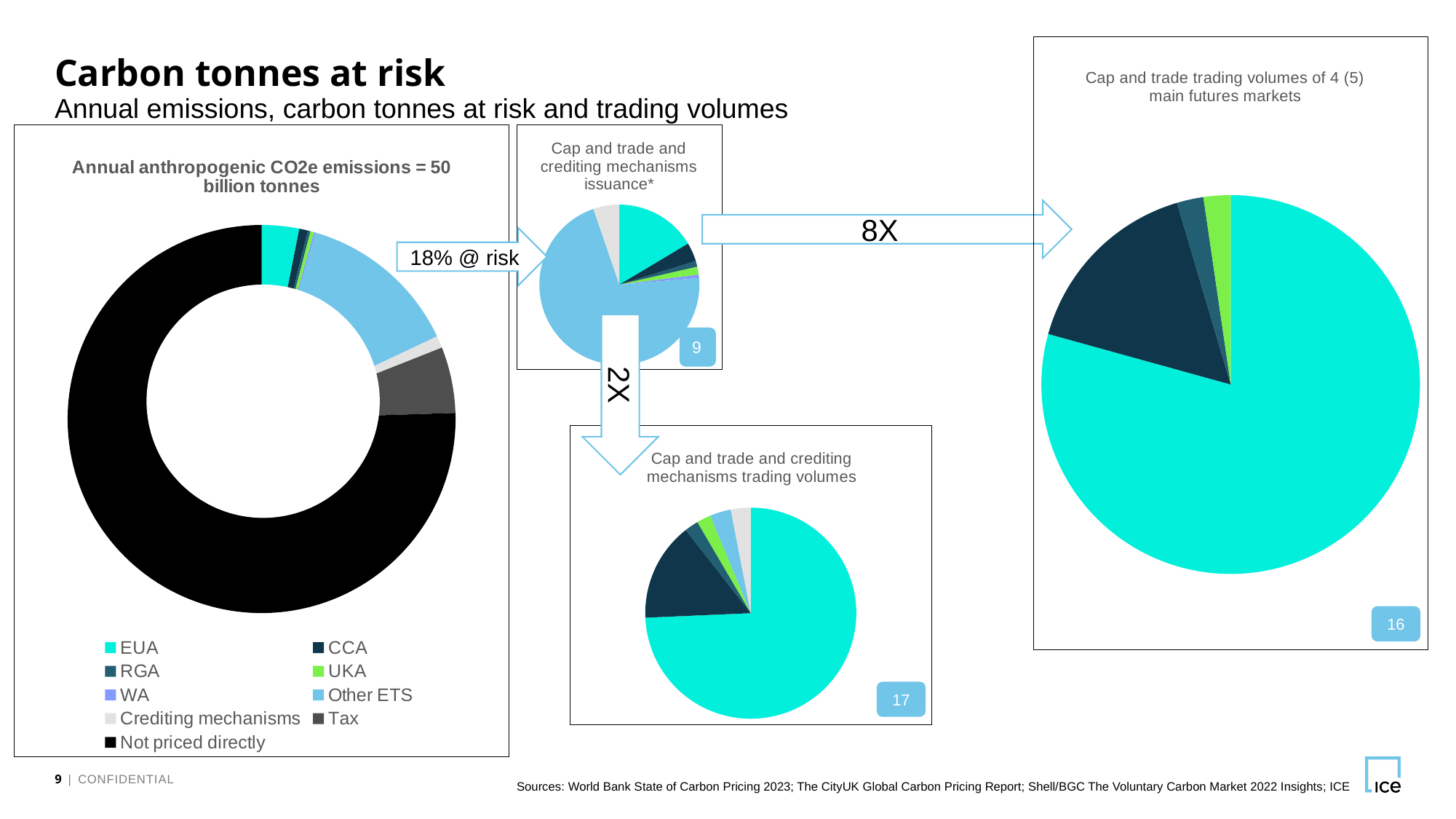
In the 'Cap and trade trading volumes of 4 (5) main futures markets' pie chart, which is larger: CCA or RGA? CCA What kind of chart is the 'Cap and trade trading volumes of 4 (5) main futures markets' chart? Pie chart In the 'Cap and trade and crediting mechanisms trading volumes' pie chart, which category has the largest slice? EUA In the 'Cap and trade trading volumes of 4 (5) main futures markets' pie chart, which category has the largest slice? EUA In the 'Annual anthropogenic CO2e emissions = 50 billion tonnes' chart, which category has the largest share? Not priced directly How many charts are shown on the slide? 4 In the 'Annual anthropogenic CO2e emissions = 50 billion tonnes' chart, which is larger: Other ETS or EUA? Other ETS What is the title of the chart on the far right of the slide? Cap and trade trading volumes of 4 (5) main futures markets What kind of chart is the 'Annual anthropogenic CO2e emissions = 50 billion tonnes' chart? Donut chart How many categories does the legend on the left of the slide list? 9 In the 'Cap and trade and crediting mechanisms trading volumes' pie chart, which is larger: EUA or CCA? EUA